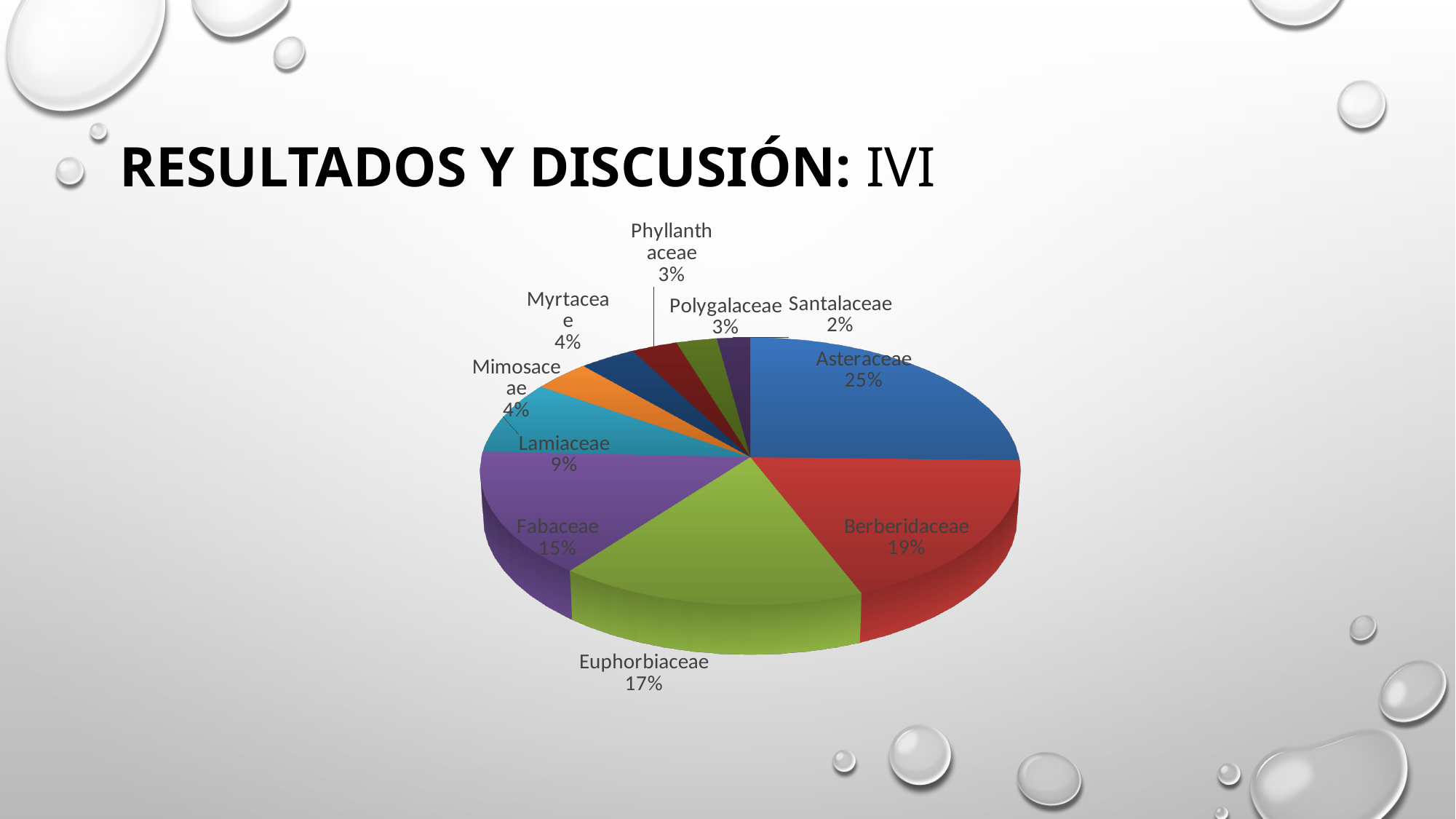
What is the title of the slide containing the pie chart? RESULTADOS Y DISCUSIÓN: IVI What share of the pie does Lamiaceae have? 9% What share of the pie does Santalaceae have? 2% What kind of chart is shown on the slide? pie chart What share of the pie does Asteraceae have? 25% Which is larger, the share for Berberidaceae or the share for Euphorbiaceae? Berberidaceae What is the difference in percentage points between Asteraceae and Fabaceae? 10 How many slices does the pie chart have? 10 Which family has the smallest slice of the pie? Santalaceae Which family has the largest slice of the pie? Asteraceae